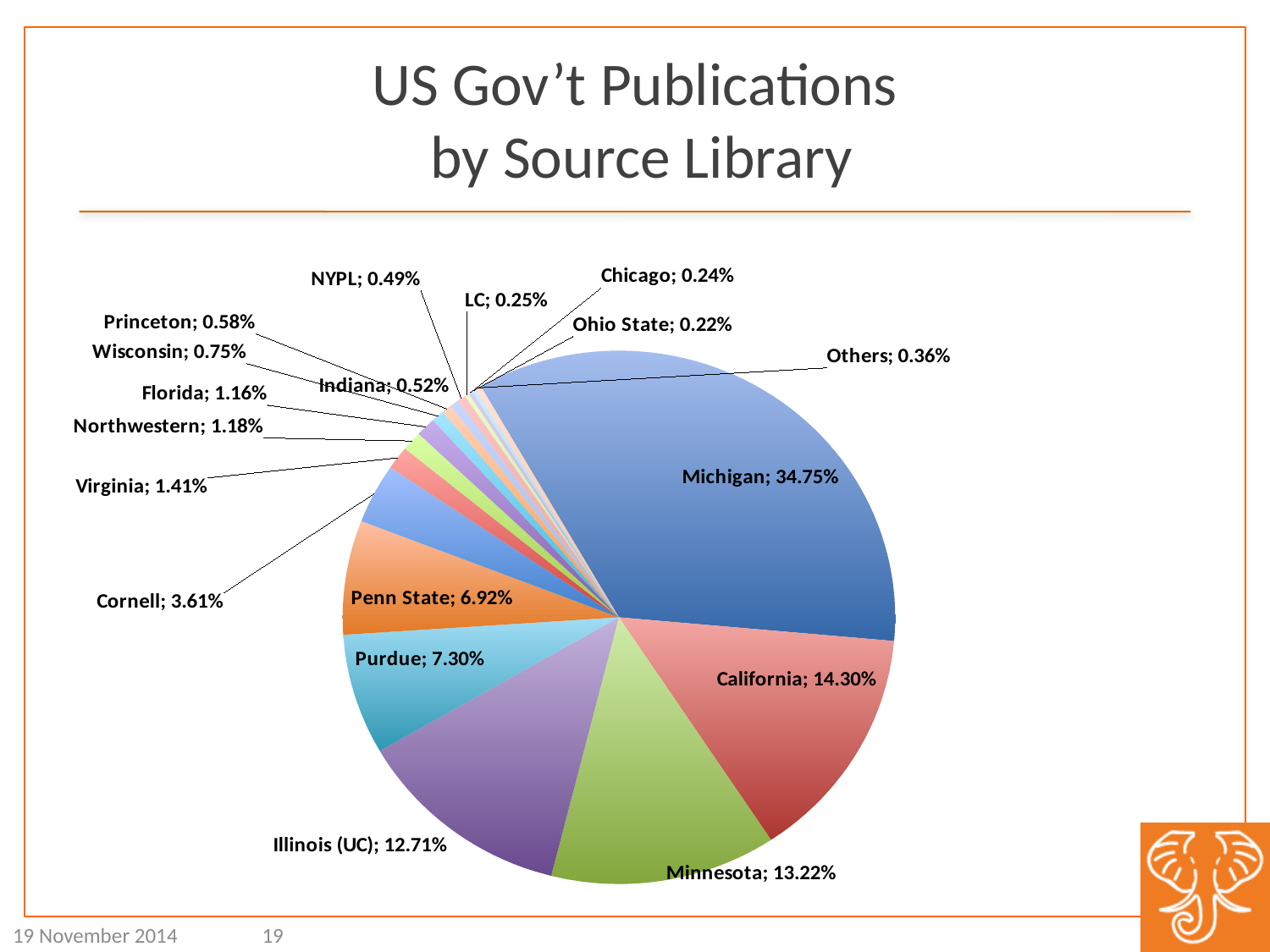
What is the difference between the shares for California and Minnesota? 1.08% Which source library has the smallest slice of the pie? Ohio State How many slices does the pie chart have? 18 Which has a larger share, Purdue or Penn State? Purdue What is the title of the chart on the slide? US Gov't Publications by Source Library What share of US Gov't Publications comes from Michigan? 34.75% What is the combined share of Michigan and California? 49.05% Which source library has the largest slice of the pie? Michigan What kind of chart is shown on the slide? pie chart What is the value shown for Ohio State? 0.22% What is the value shown for Purdue? 7.30% What percentage is labelled for Cornell? 3.61%